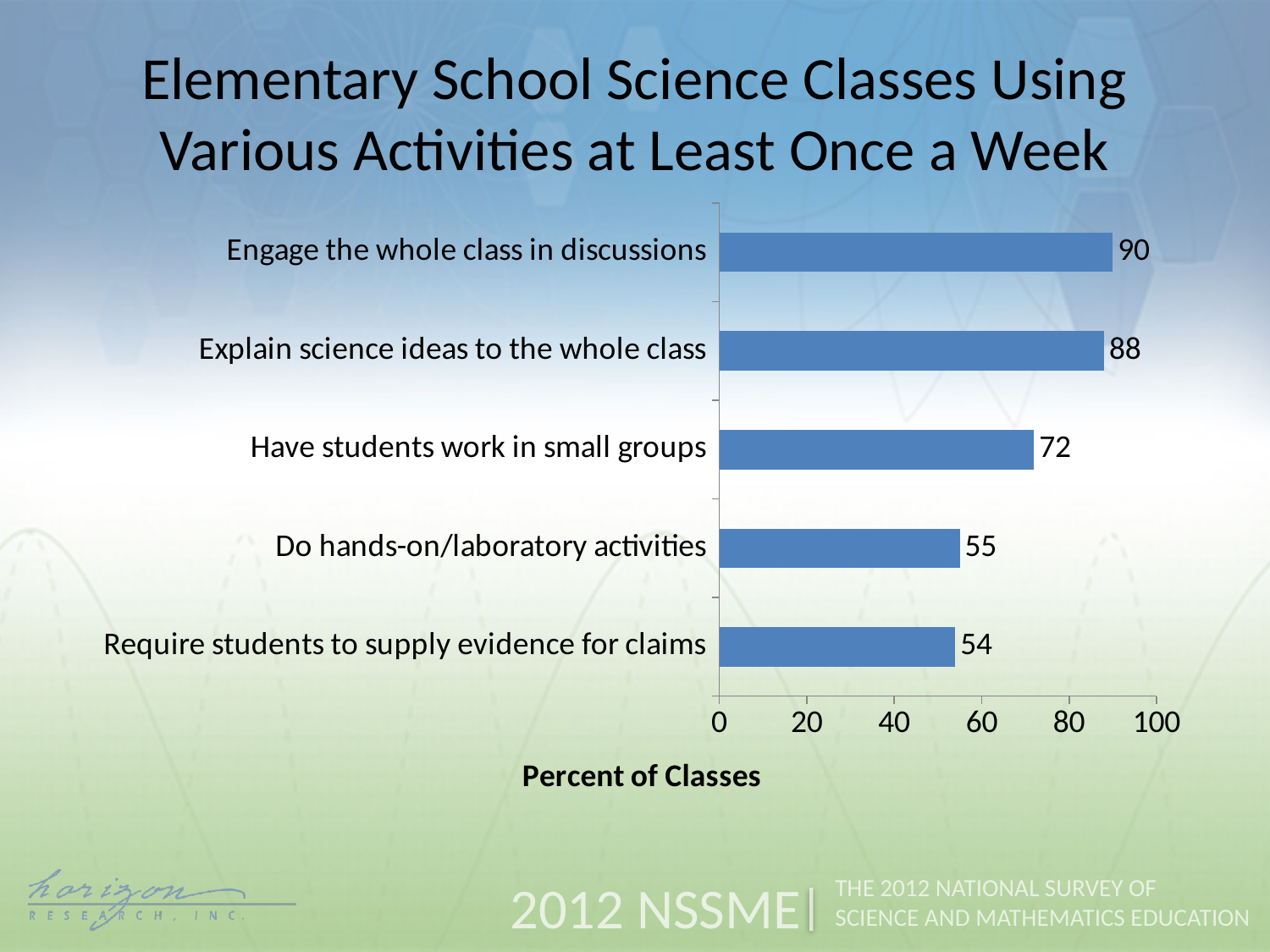
How many activities are shown in the chart? 5 What is the maximum value shown on the horizontal axis? 100 What percent of classes engage the whole class in discussions at least once a week? 90 Which is larger: 'Have students work in small groups' or 'Do hands-on/laboratory activities'? Have students work in small groups What is the value for 'Have students work in small groups'? 72 What is the difference between 'Engage the whole class in discussions' and 'Have students work in small groups'? 18 What is the label of the horizontal axis? Percent of Classes Which activity has the highest percent of classes? Engage the whole class in discussions Which activity has the lowest percent of classes? Require students to supply evidence for claims What is the value for 'Do hands-on/laboratory activities'? 55 What kind of chart is shown on the slide? Bar chart What is the difference between 'Explain science ideas to the whole class' and 'Do hands-on/laboratory activities'? 33